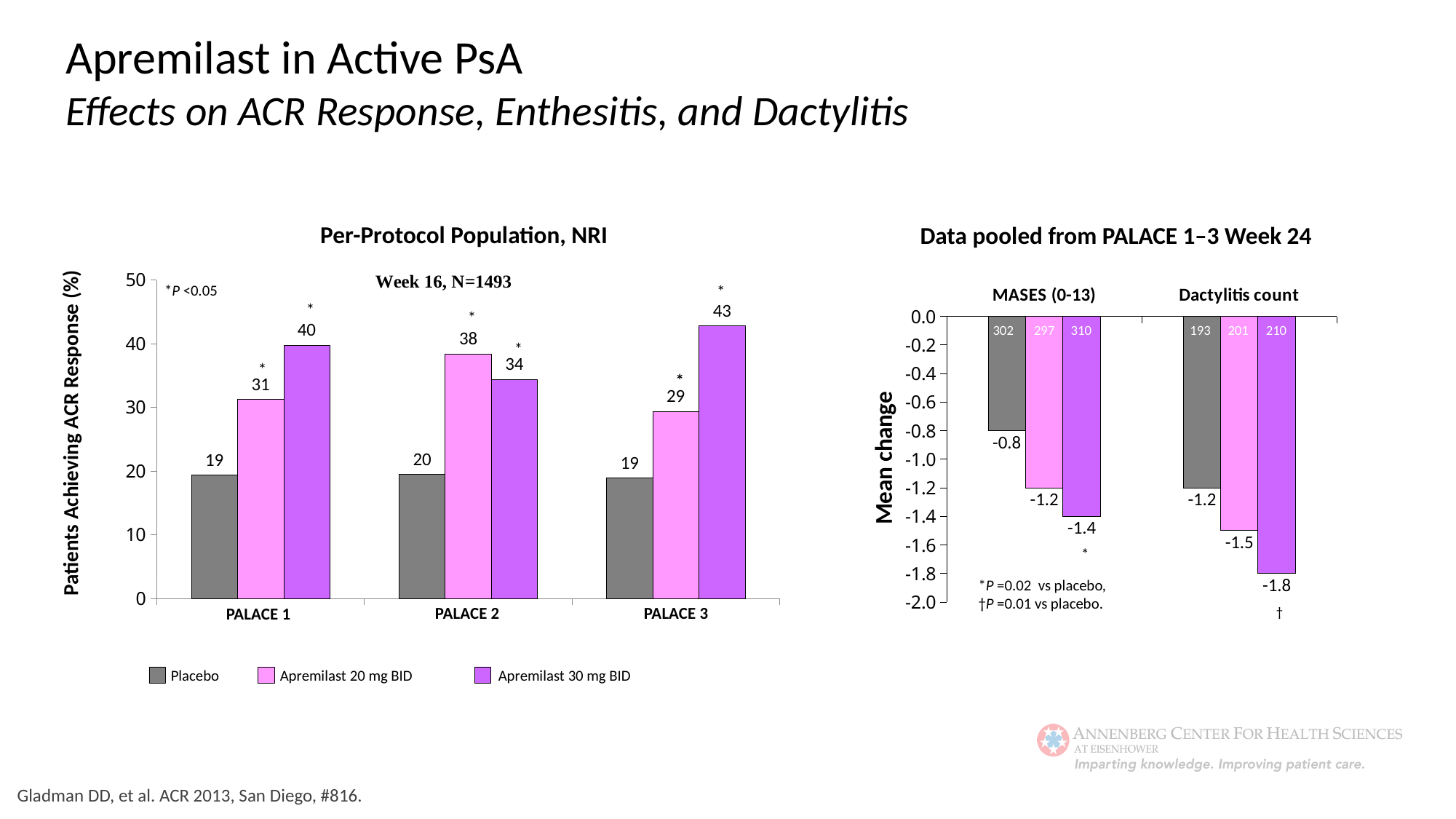
In the left chart (Per-Protocol Population, NRI), what is the difference between Apremilast 20 mg BID and Placebo in PALACE 1? 12 In the right chart (Data pooled from PALACE 1–3 Week 24), what is the mean change in Dactylitis count for Apremilast 30 mg BID? -1.8 In the right chart (Data pooled from PALACE 1–3 Week 24), what is the difference between the Apremilast 30 mg BID and Placebo mean change in MASES? 0.6 In the left chart (Per-Protocol Population, NRI), what is the value for Placebo in PALACE 2? 20 In the left chart (Per-Protocol Population, NRI), how many series does the legend list? 3 In the left chart (Per-Protocol Population, NRI), what is the label of the y axis? Patients Achieving ACR Response (%) In the left chart (Per-Protocol Population, NRI), which study has the highest value for Apremilast 30 mg BID? PALACE 3 In the left chart (Per-Protocol Population, NRI), how many studies are shown on the x axis? 3 In the right chart (Data pooled from PALACE 1–3 Week 24), what is the mean change in MASES for Placebo? -0.8 In the left chart (Per-Protocol Population, NRI), which is larger in PALACE 2: Apremilast 20 mg BID or Apremilast 30 mg BID? Apremilast 20 mg BID In the left chart (Per-Protocol Population, NRI), what percentage of patients achieved ACR response with Apremilast 30 mg BID in PALACE 1? 40 What kind of chart is the right chart (Data pooled from PALACE 1–3 Week 24)? Bar chart